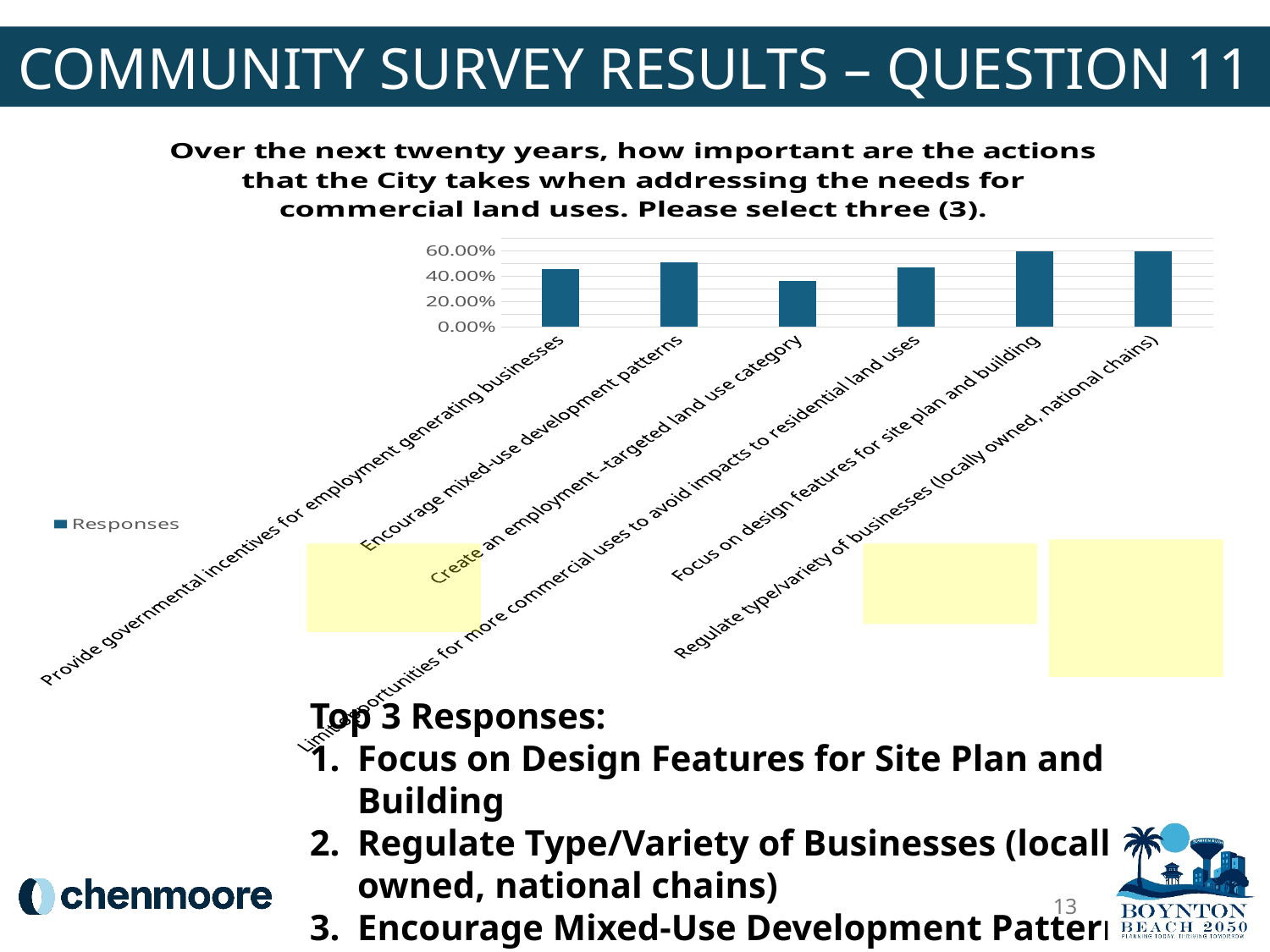
Is the value for "Encourage mixed-use development patterns" greater or less than 40.00%? greater What kind of chart is shown on the slide? Bar chart Which is larger: the value for "Encourage mixed-use development patterns" or the value for "Create an employment –targeted land use category"? Encourage mixed-use development patterns Is the value for "Provide governmental incentives for employment generating businesses" greater or less than 40.00%? greater What is the name of the series shown in the chart legend? Responses How many categories (bars) does the chart show? 6 Which category has the lowest value in the chart? Create an employment –targeted land use category How many series does the chart legend list? 1 Is the value for "Create an employment –targeted land use category" greater or less than 40.00%? less What is the highest value shown on the chart's vertical axis? 60.00% Which is larger: the value for "Focus on design features for site plan and building" or the value for "Provide governmental incentives for employment generating businesses"? Focus on design features for site plan and building